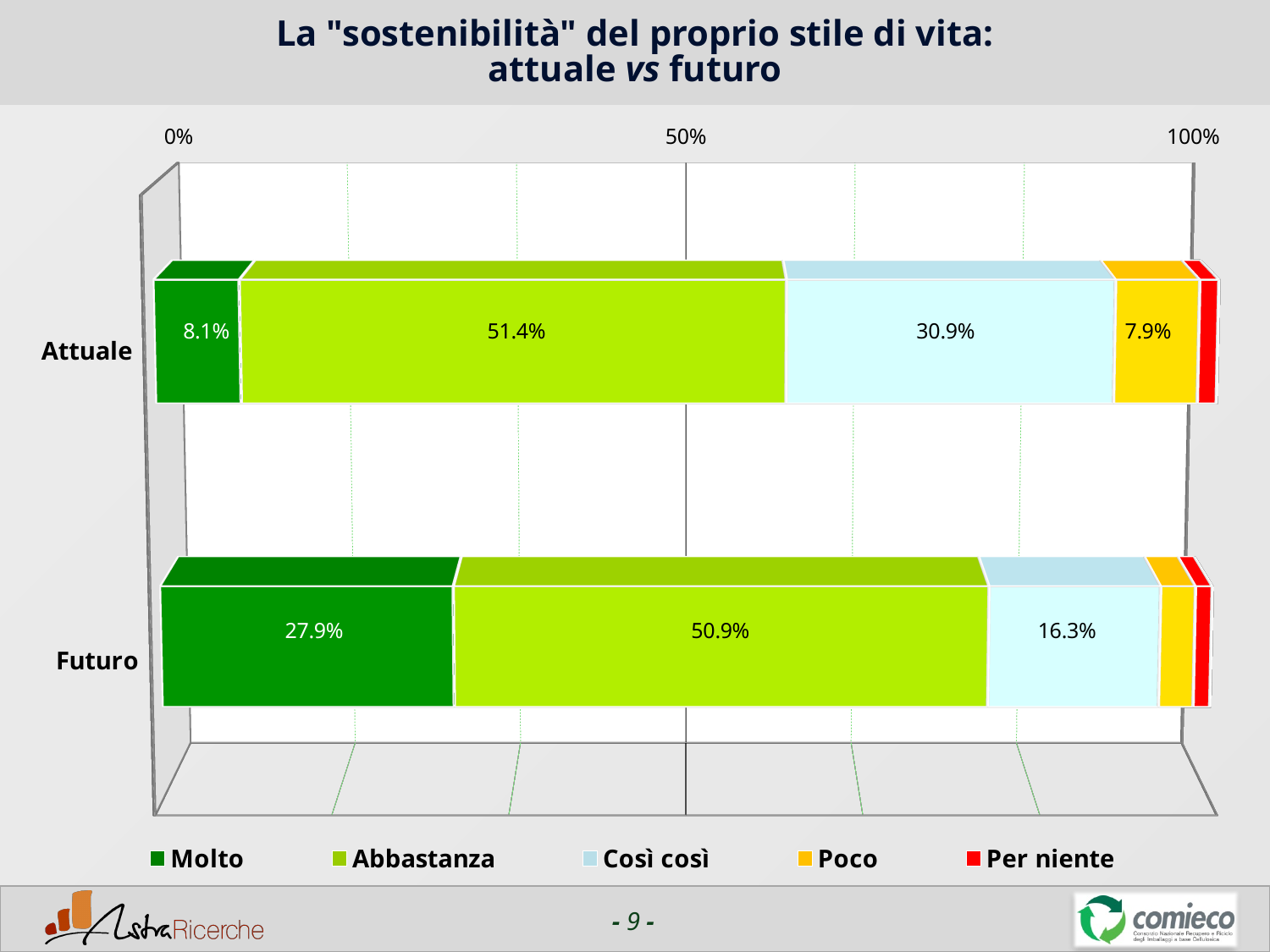
Which category has the larger Molto segment, Attuale or Futuro? Futuro Which category has the larger Così così segment, Attuale or Futuro? Attuale What kind of chart is shown on the slide? Stacked bar chart How many series does the legend list? 5 What is the difference between the Molto values for Futuro and Attuale? 19.8% What is the value of the Così così segment for Attuale? 30.9% What is the difference between the Così così values for Attuale and Futuro? 14.6% What is the value of the Molto segment for Attuale? 8.1% What is the value of the Molto segment for Futuro? 27.9% How many categories are shown on the chart? 2 What is the value of the Abbastanza segment for Futuro? 50.9% What is the value of the Poco segment for Attuale? 7.9%